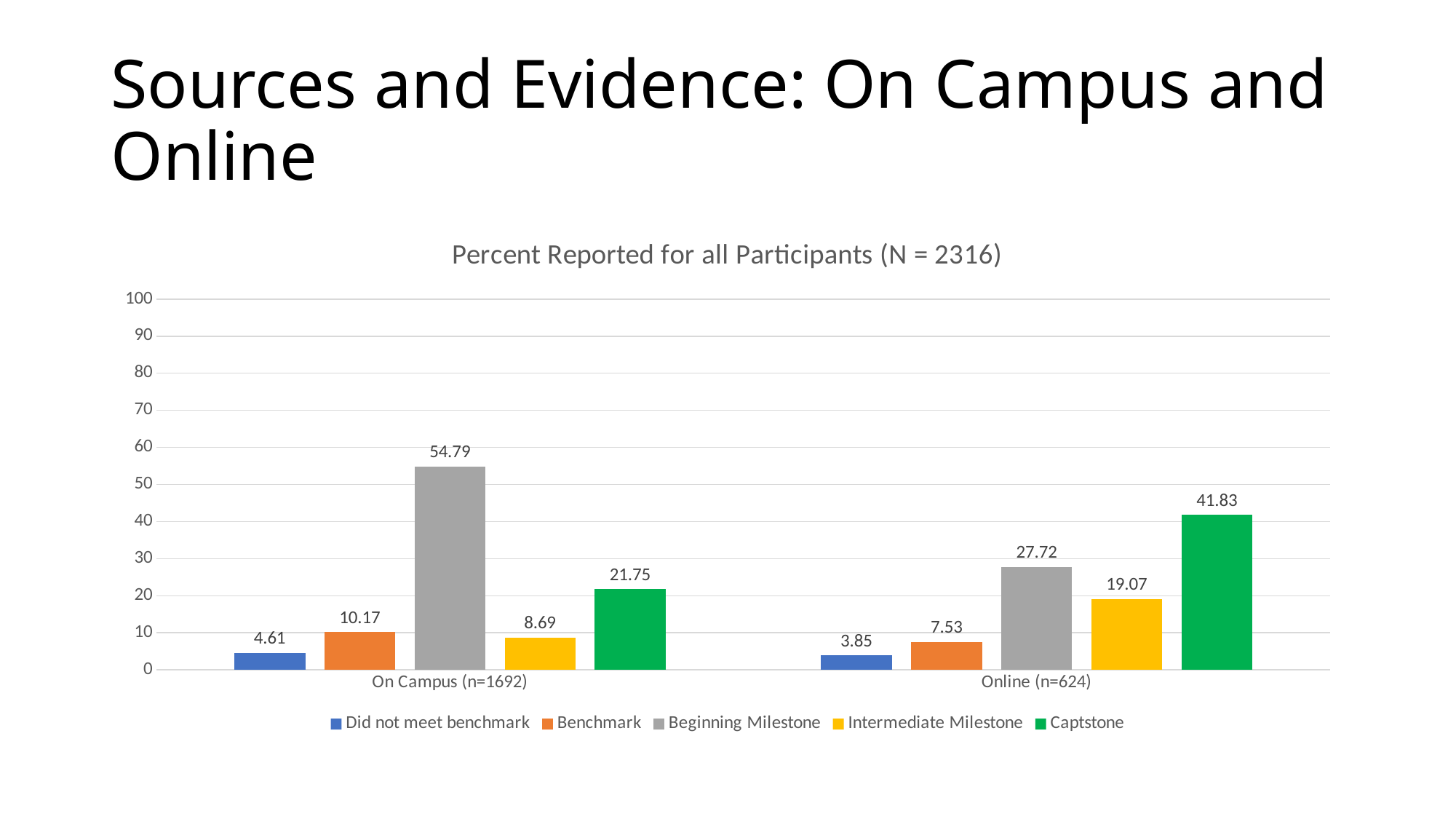
Which series has the lowest value in the Online (n=624) group? Did not meet benchmark What is the value for Captstone in the Online (n=624) group? 41.83 How many series does the legend list? 5 Which series has the highest value in the On Campus (n=1692) group? Beginning Milestone What is the value for Did not meet benchmark in the Online (n=624) group? 3.85 What is the title of the chart? Percent Reported for all Participants (N = 2316) Is the value for Captstone in the Online (n=624) group greater or less than 40? greater What kind of chart is shown on the slide? Bar chart What is the value for Beginning Milestone in the On Campus (n=1692) group? 54.79 Which is larger: the Captstone value for On Campus (n=1692) or for Online (n=624)? Online (n=624) What is the value for Intermediate Milestone in the On Campus (n=1692) group? 8.69 What is the difference between the Beginning Milestone values for On Campus (n=1692) and Online (n=624)? 27.07